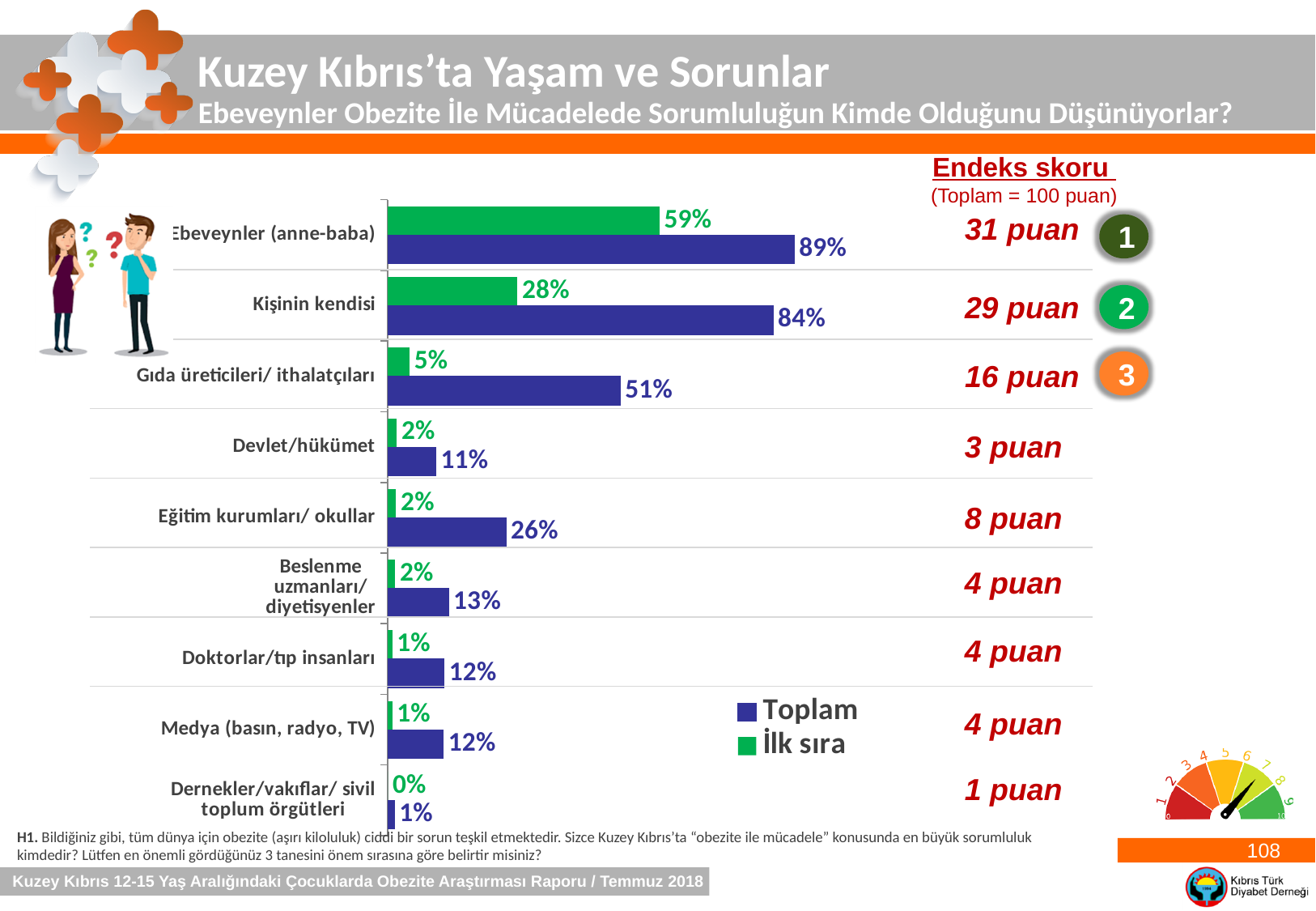
Which is larger, the Toplam value for Eğitim kurumları/ okullar or the Toplam value for Devlet/hükümet? Eğitim kurumları/ okullar How many categories are shown in the chart? 9 What is the Endeks skoru shown for Gıda üreticileri/ ithalatçıları? 16 puan How many series does the legend list? 2 Which category has the highest Toplam value? Ebeveynler (anne-baba) What is the İlk sıra value for Kişinin kendisi? 28% What is the Toplam value for Ebeveynler (anne-baba)? 89% What are the two series named in the legend? Toplam and İlk sıra What kind of chart is shown on the slide? Bar chart Which category has the lowest İlk sıra value? Dernekler/vakıflar/ sivil toplum örgütleri What is the difference between the Toplam and İlk sıra values for Kişinin kendisi? 56% What is the Toplam value for Gıda üreticileri/ ithalatçıları? 51%